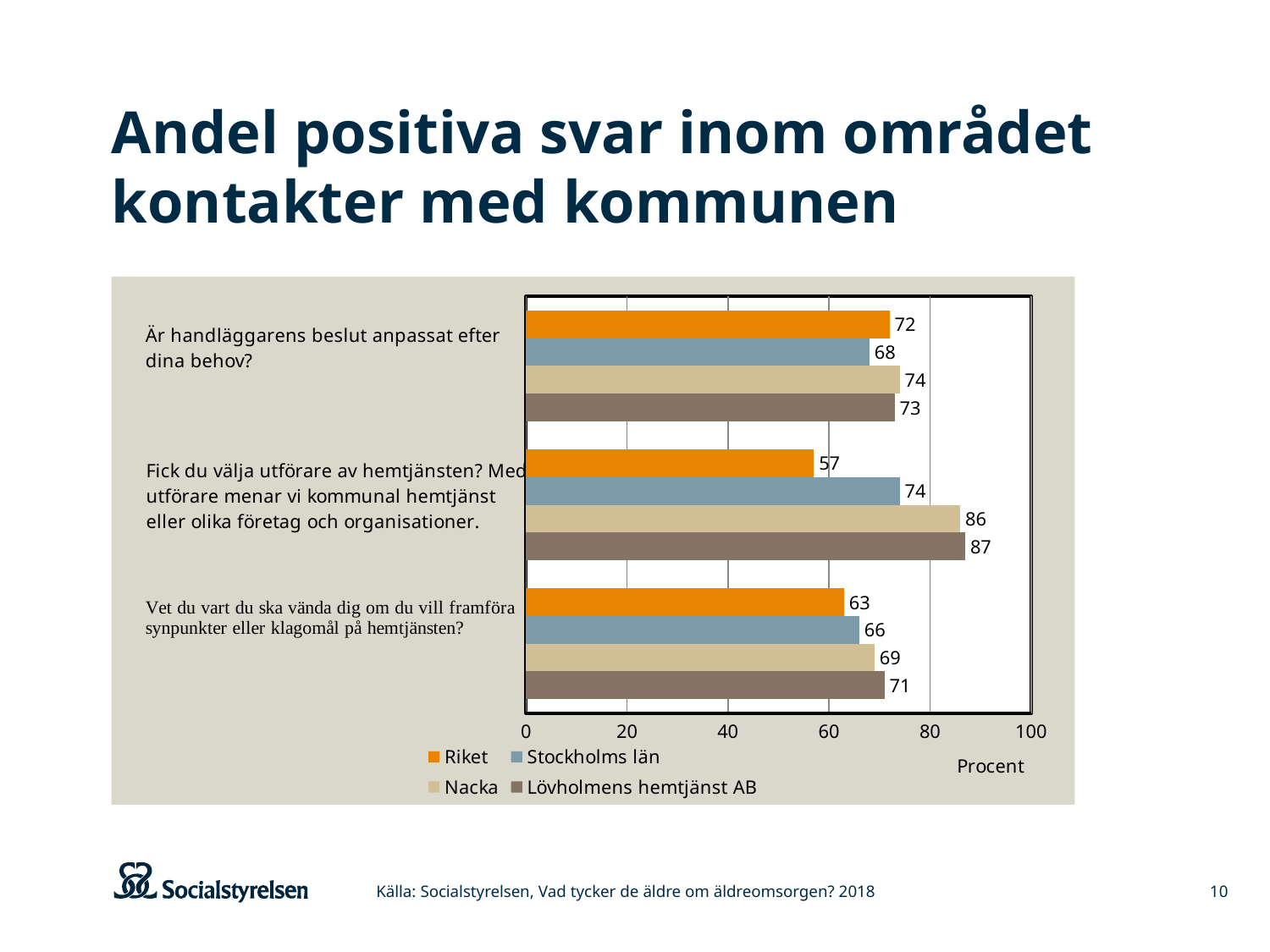
How many series does the legend list? 4 Which series has the highest value on the question "Fick du välja utförare av hemtjänsten?"? Lövholmens hemtjänst AB What kind of chart is shown on the slide? Bar chart Is the value for Riket on the question "Fick du välja utförare av hemtjänsten?" greater or less than 60? less Which series has the lowest value on the question "Är handläggarens beslut anpassat efter dina behov?"? Stockholms län What is the value for Lövholmens hemtjänst AB on the question "Är handläggarens beslut anpassat efter dina behov?"? 73 How many question categories are plotted on the chart? 3 Which is larger on the question "Vet du vart du ska vända dig...": Stockholms län or Lövholmens hemtjänst AB? Lövholmens hemtjänst AB What unit label is shown on the x axis of the chart? Procent What is the value for Riket on the question "Fick du välja utförare av hemtjänsten?"? 57 What is the value for Nacka on the question "Vet du vart du ska vända dig om du vill framföra synpunkter eller klagomål på hemtjänsten?"? 69 What is the difference between Nacka and Riket on the question "Fick du välja utförare av hemtjänsten?"? 29